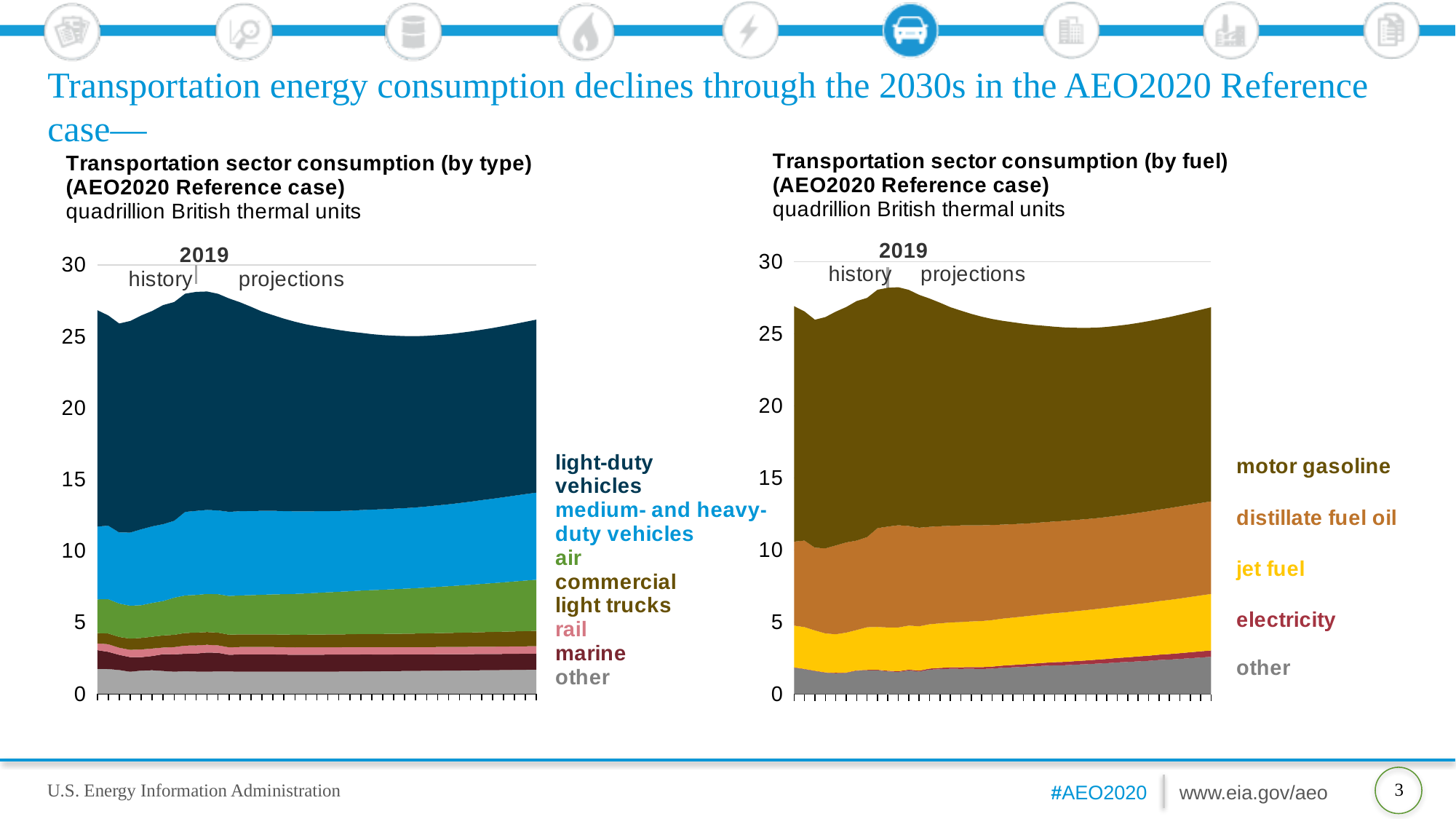
In the 'Transportation sector consumption (by fuel)' chart, is the total consumption at its 2019 peak greater or less than 30 quadrillion British thermal units? less In the 'Transportation sector consumption (by fuel)' chart, is the 'other' band at the bottom greater or less than 5 quadrillion British thermal units? less What kind of chart is the 'Transportation sector consumption (by type)' chart on the left? stacked area chart How many series does the legend of the 'Transportation sector consumption (by type)' chart list? 7 How many series does the legend of the 'Transportation sector consumption (by fuel)' chart list? 5 In the 'Transportation sector consumption (by type)' chart, does total consumption rise or fall in the years immediately after 2019? fall In the 'Transportation sector consumption (by type)' chart, which series accounts for the largest share of consumption? light-duty vehicles In the 'Transportation sector consumption (by type)' chart, is the total consumption at its 2019 peak greater or less than 25 quadrillion British thermal units? greater What unit of measurement is used on both charts? quadrillion British thermal units In the 'Transportation sector consumption (by type)' chart, which series is the thinnest band (smallest consumption)? rail In the 'Transportation sector consumption (by fuel)' chart, which fuel is the thinnest band (smallest consumption)? electricity In the 'Transportation sector consumption (by fuel)' chart, which fuel accounts for the largest share of consumption? motor gasoline